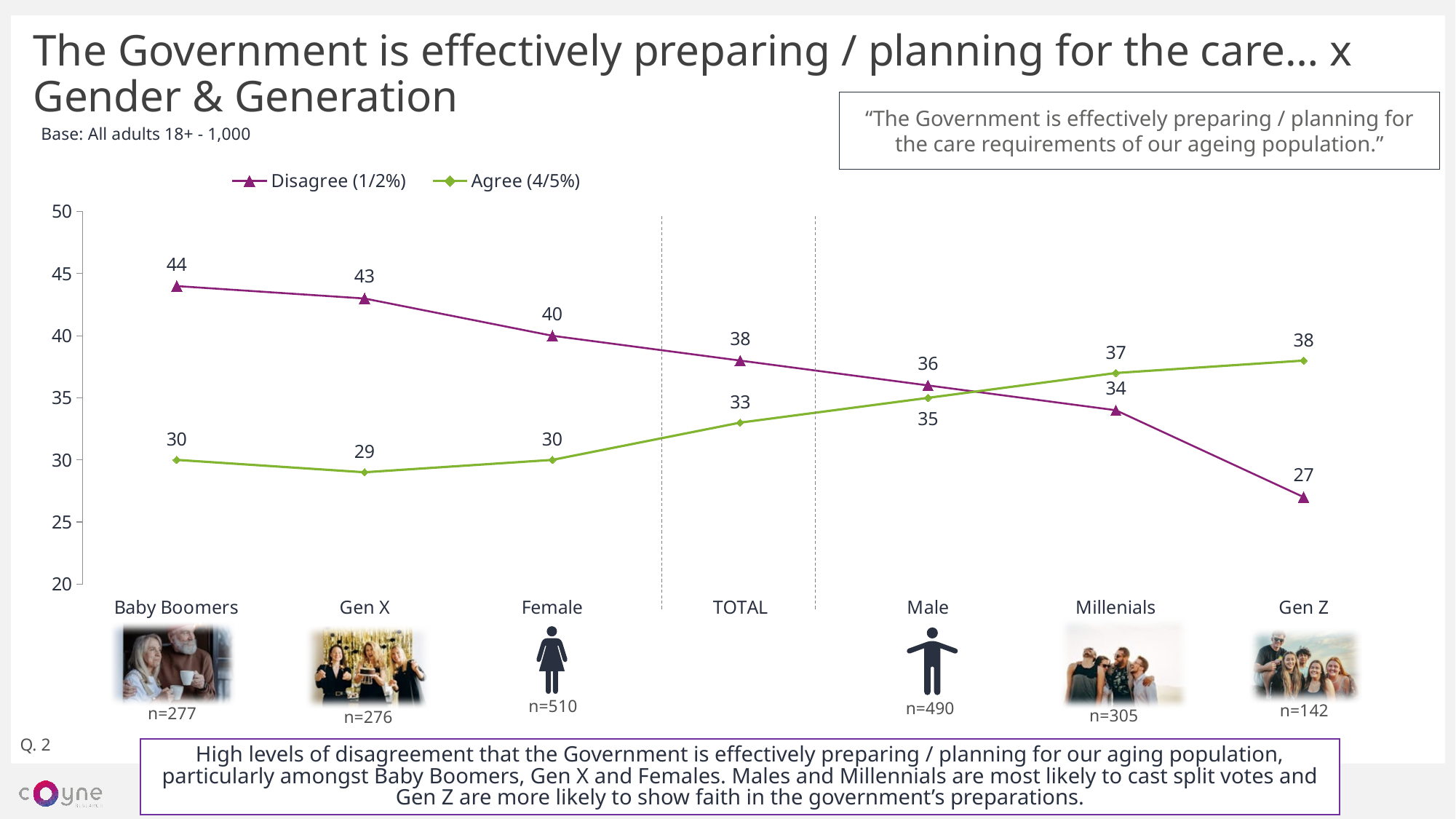
For Millenials, which is larger: the Disagree (1/2%) value or the Agree (4/5%) value? Agree (4/5%) What is the difference between the Disagree (1/2%) and Agree (4/5%) values for Baby Boomers? 14 What is the Agree (4/5%) value for TOTAL? 33 How many series does the legend list? 2 What is the Agree (4/5%) value for Gen Z? 38 What is the Disagree (1/2%) value for Baby Boomers? 44 Which category has the highest Agree (4/5%) value? Gen Z How many categories are shown on the x axis? 7 Which category has the lowest Disagree (1/2%) value? Gen Z What kind of chart is shown on the slide? Line chart Does the Disagree (1/2%) series rise or fall from Baby Boomers to Gen Z? Fall What is the sample size (n) shown for Gen Z? n=142